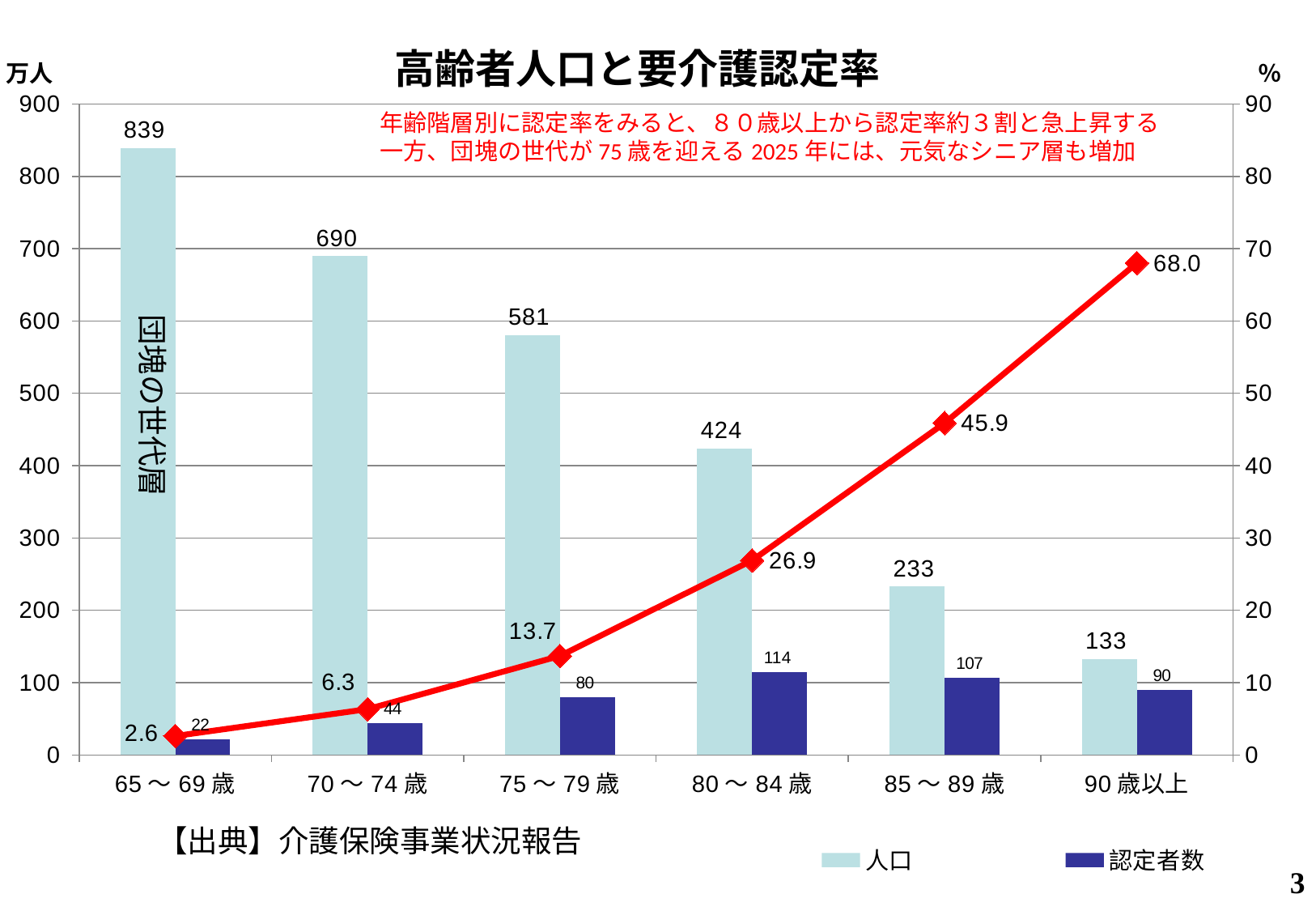
What is the 人口 value for the 65～69歳 age group? 839 How many age groups are shown on the x axis? 6 How many series does the legend list? 2 What value does the red line show for the 90歳以上 age group? 68.0 What is the difference between the 人口 values for 70～74歳 and 75～79歳? 109 Which age group has the lowest 認定者数 value? 65～69歳 Does the red line rise or fall from 65～69歳 to 90歳以上? Rise What is the title of the chart? 高齢者人口と要介護認定率 What kind of chart is this? Combined bar and line chart Which age group has the highest 人口 value? 65～69歳 What is the 認定者数 value for the 80～84歳 age group? 114 Which is larger, the 認定者数 value for 85～89歳 or for 90歳以上? 85～89歳